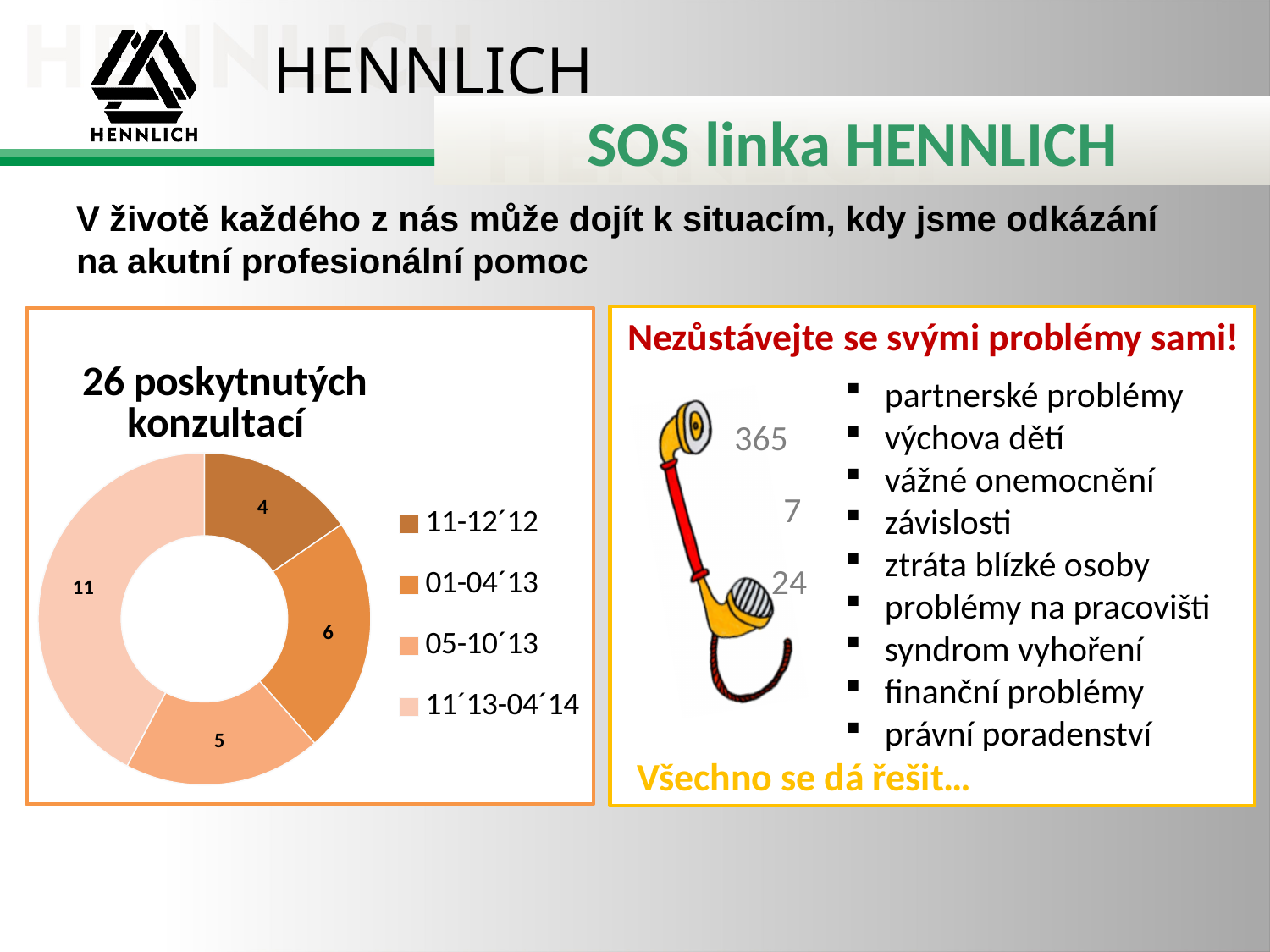
What is the value for 11´13-04´14 in the chart? 11 What is the value for 05-10´13 in the chart? 5 Which period has the highest value in the chart? 11´13-04´14 What kind of chart is shown on the slide? doughnut chart What is the value for 11-12´12 in the chart? 4 How many segments does the doughnut chart have? 4 What is the title of the chart on the slide? 26 poskytnutých konzultací What is the value for 01-04´13 in the chart? 6 Which period has the lowest value in the chart? 11-12´12 How many entries does the chart legend list? 4 What is the difference between the values for 11´13-04´14 and 01-04´13? 5 Which is larger, the value for 01-04´13 or the value for 05-10´13? 01-04´13